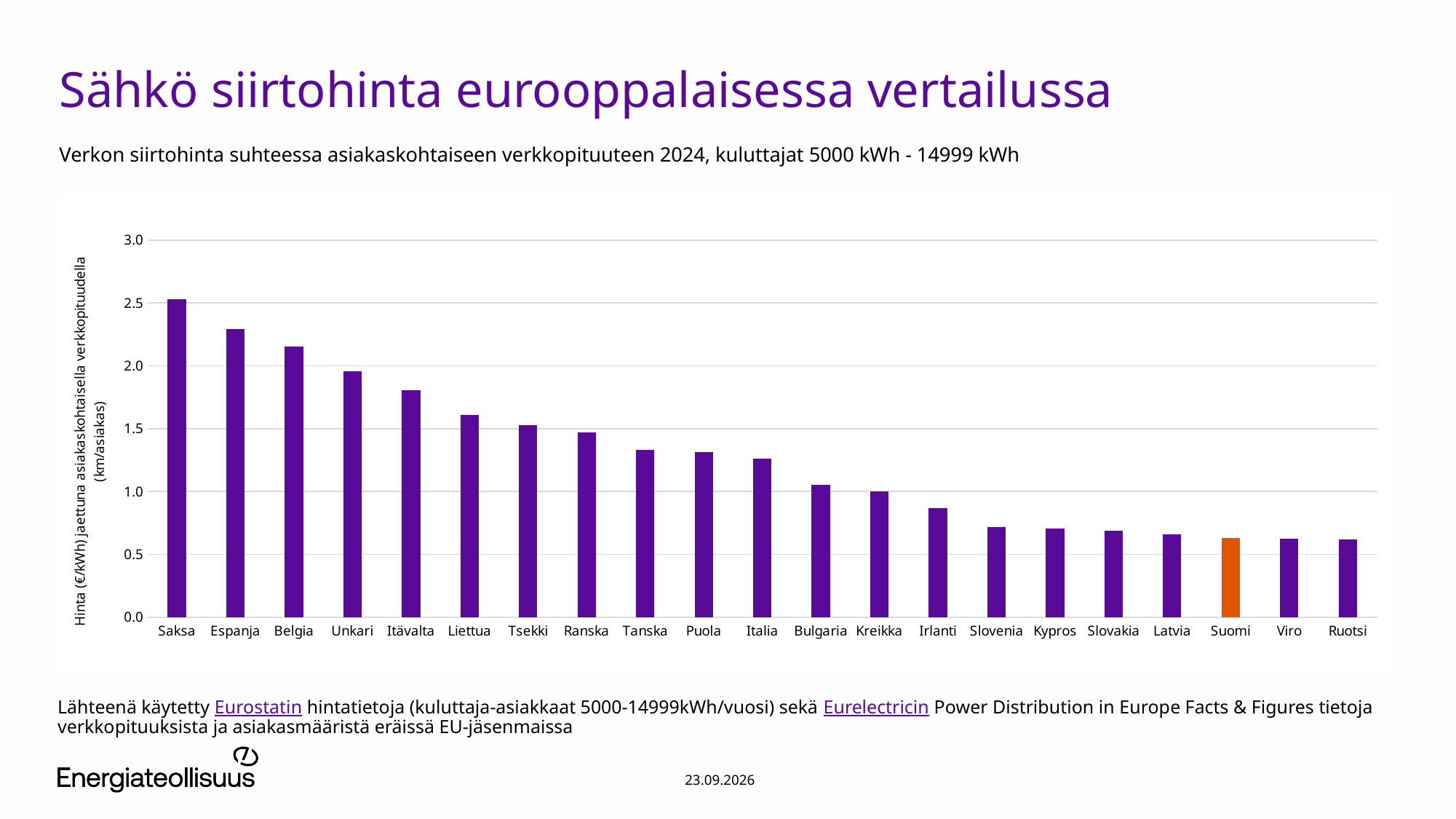
Is the value for Tanska greater or less than 1.5? less Do the values rise or fall from left to right along the x axis? fall How many countries are shown in the chart? 21 Which has a higher value, Unkari or Itävalta? Unkari What kind of chart is shown on the slide? bar chart Is the value for Irlanti greater or less than 1.0? less Is the value for Espanja greater or less than 2.0? greater Which has a higher value, Saksa or Espanja? Saksa Which country has the highest value in the chart? Saksa Which country's bar is highlighted in orange? Suomi